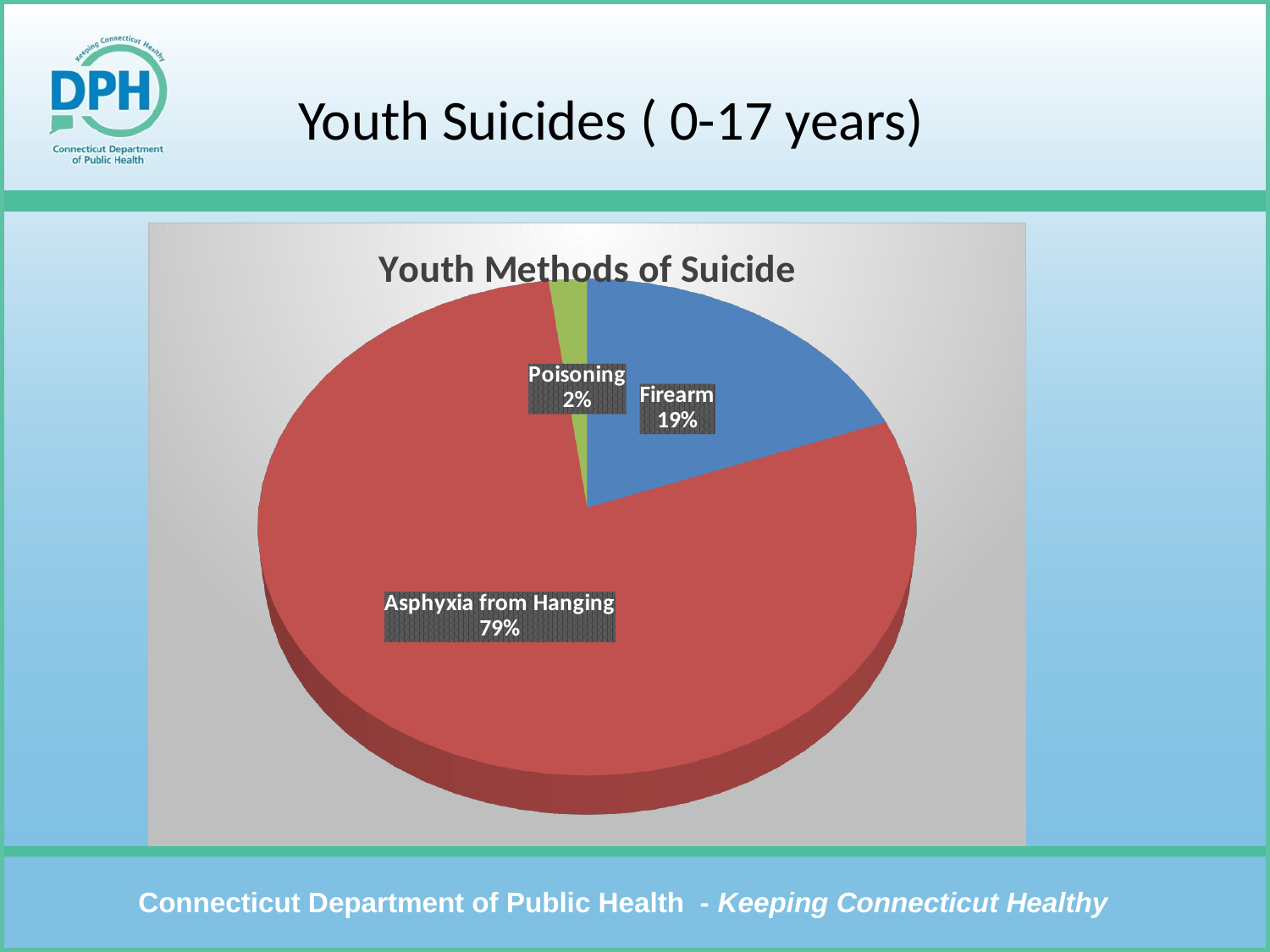
Which method has the smallest share of the pie? Poisoning What is the difference in percentage points between Asphyxia from Hanging and Firearm? 60 Which has a larger share, Firearm or Poisoning? Firearm What share of the pie does Asphyxia from Hanging represent? 79% Which method has the largest share of the pie? Asphyxia from Hanging What share of the pie does Poisoning represent? 2% What kind of chart is shown on the slide? Pie chart What is the difference in percentage points between Firearm and Poisoning? 17 What share of the pie does Firearm represent? 19% How many slices does the pie chart have? 3 What is the title of the chart? Youth Methods of Suicide What colour is the Firearm slice? Blue